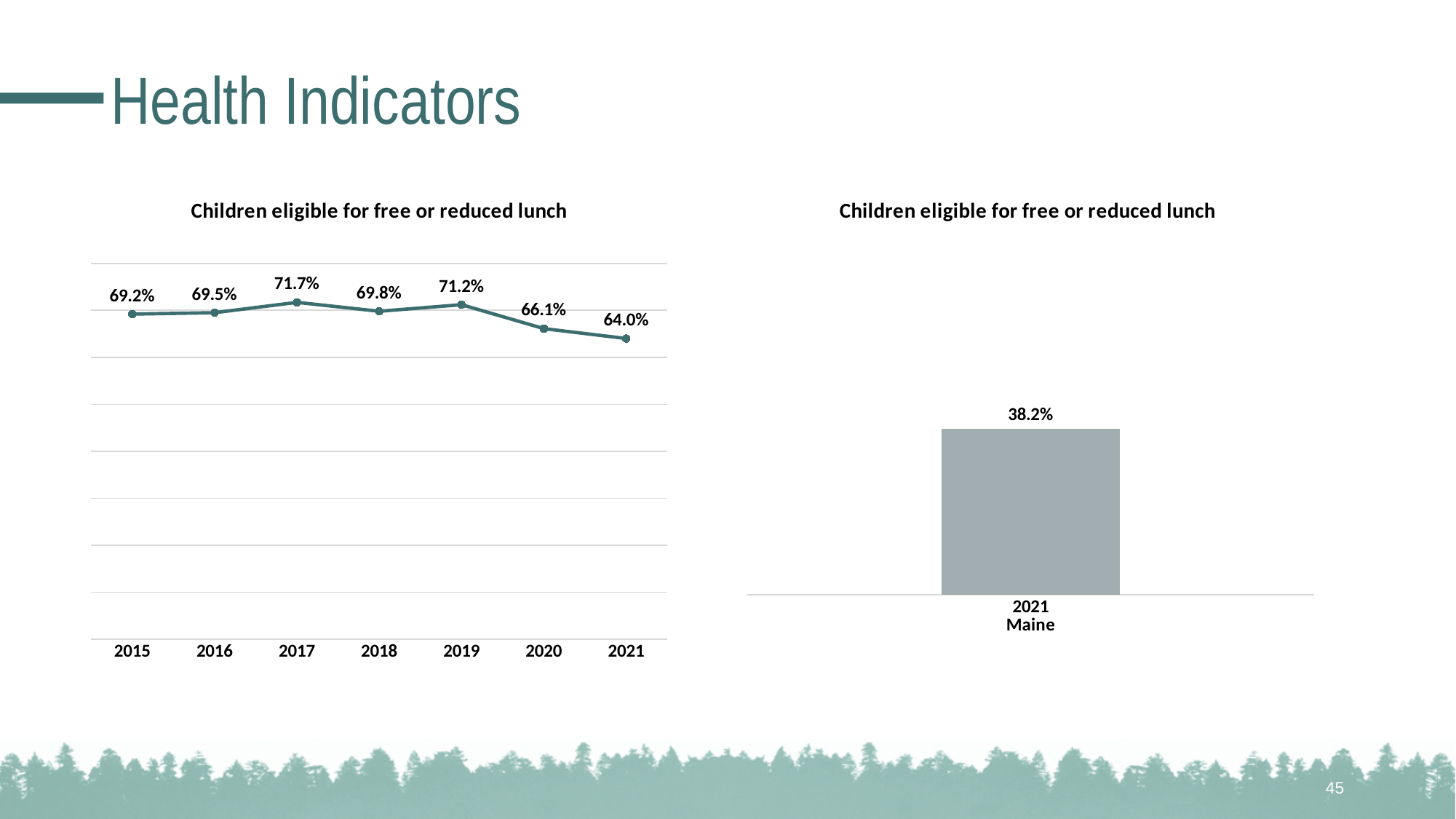
In the left chart, which year has the highest value? 2017 In the left chart, which is larger, the value for 2016 or the value for 2020? 2016 In the left chart, what is the value for 2017? 71.7% In the left chart, what is the difference between the 2019 value and the 2020 value? 5.1% What kind of chart is the right chart? bar chart In the left chart, do the values rise or fall from 2019 to 2021? fall What kind of chart is the left chart? line chart In the left chart, what is the value for 2015? 69.2% In the left chart, what is the value for 2021? 64.0% How many years are plotted in the left chart? 7 In the right chart, what is the value for 2021 Maine? 38.2% In the left chart, which year has the lowest value? 2021